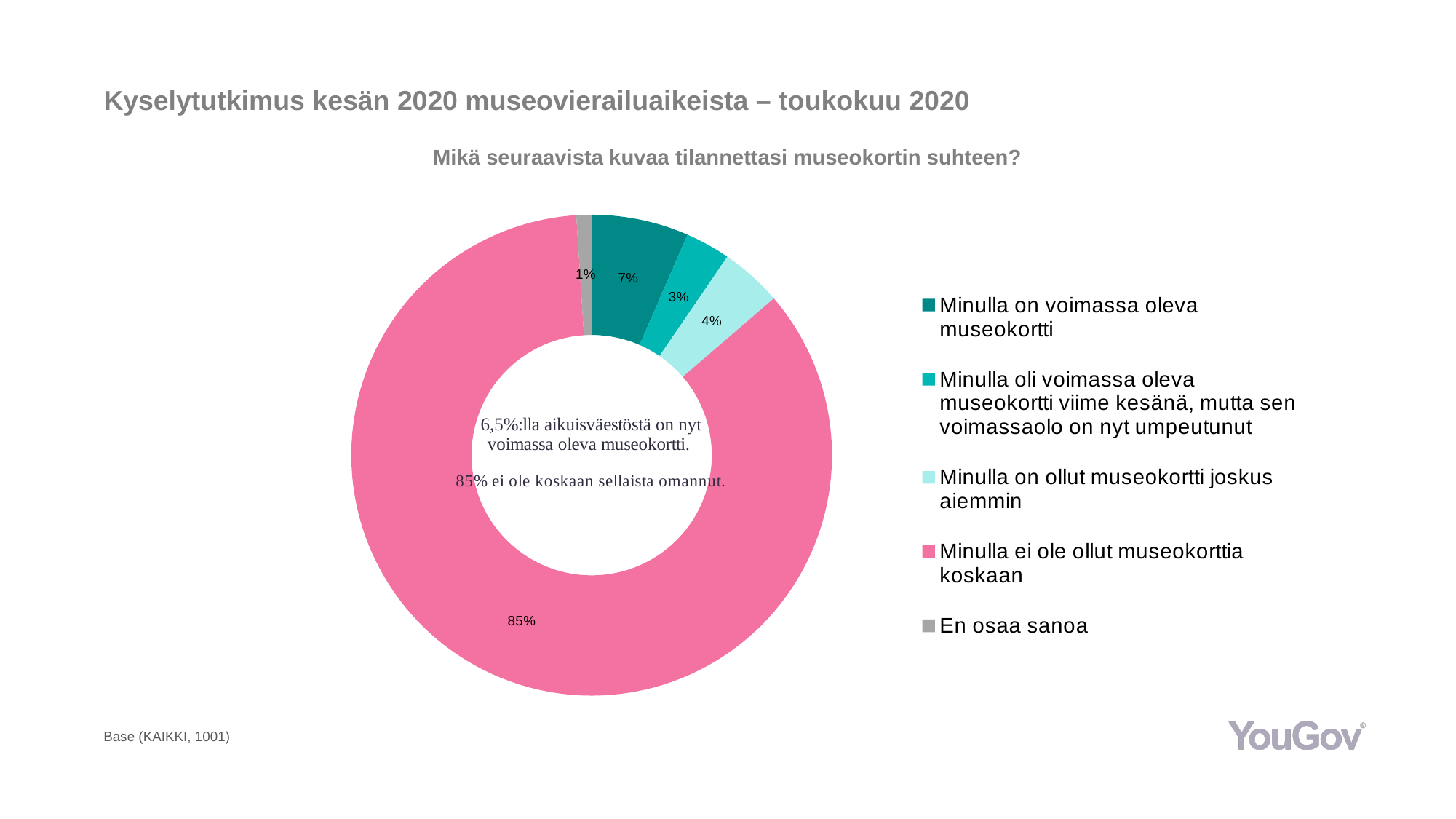
What share of respondents answered "Minulla on voimassa oleva museokortti"? 7% Which category has the smallest slice of the chart? En osaa sanoa What share of respondents answered "En osaa sanoa"? 1% Which is larger: the share for "Minulla on voimassa oleva museokortti" or the share for "Minulla on ollut museokortti joskus aiemmin"? Minulla on voimassa oleva museokortti What share of respondents answered "Minulla ei ole ollut museokorttia koskaan"? 85% What share of respondents answered "Minulla on ollut museokortti joskus aiemmin"? 4% What is the difference in percentage points between "Minulla on voimassa oleva museokortti" and "Minulla on ollut museokortti joskus aiemmin"? 3 How many categories does the legend list? 5 Which category has the largest slice of the chart? Minulla ei ole ollut museokorttia koskaan What is the base size shown at the bottom of the slide? 1001 What kind of chart is shown on the slide? Pie chart (donut) What share of respondents said their museum card was valid last summer but has now expired? 3%